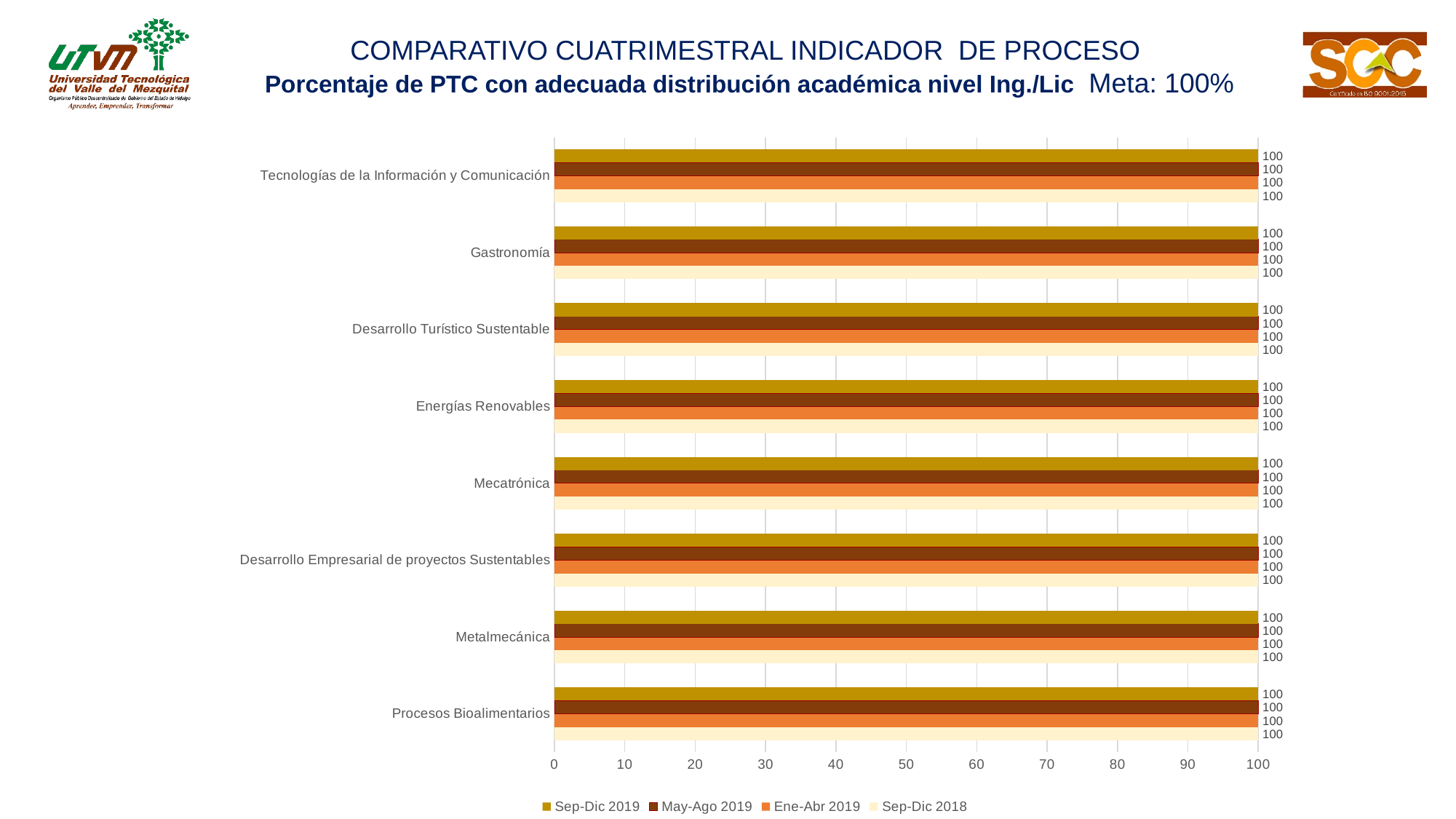
What is the difference between the Sep-Dic 2019 value for Metalmecánica and the Sep-Dic 2019 value for Gastronomía? 0 What target (Meta) is stated in the chart title? 100% Which series is listed first in the legend? Sep-Dic 2019 What is the value for Energías Renovables in the May-Ago 2019 series? 100 What is the value for Procesos Bioalimentarios in the Ene-Abr 2019 series? 100 How many categories (programs) are shown on the chart? 8 What is the value for Tecnologías de la Información y Comunicación in the Sep-Dic 2019 series? 100 Is the value for Desarrollo Turístico Sustentable in the Ene-Abr 2019 series greater or less than 90? greater What is the value for Gastronomía in the Sep-Dic 2019 series? 100 How many series does the legend list? 4 What kind of chart is shown on the slide? bar chart What is the value for Mecatrónica in the Sep-Dic 2018 series? 100